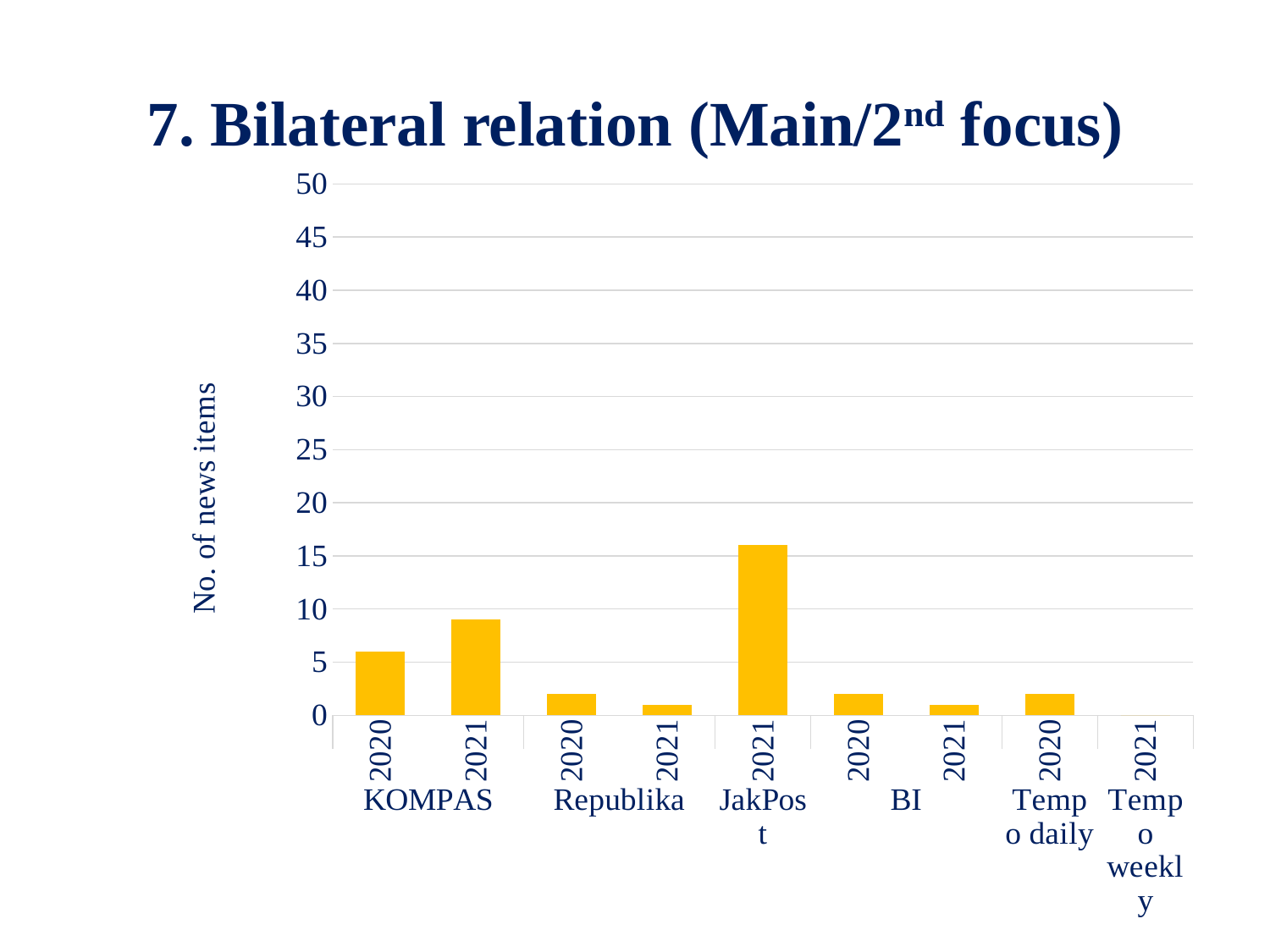
Is the value for Republika 2020 greater or less than 5? less What is the title of the chart on the slide? 7. Bilateral relation (Main/2nd focus) Which bar is the lowest in the chart? Tempo weekly 2021 Which bar is the highest in the chart? JakPost 2021 Which is larger, the value for KOMPAS 2020 or KOMPAS 2021? KOMPAS 2021 Is the value for JakPost 2021 greater or less than 10? greater Which is larger, the value for Republika 2020 or Republika 2021? Republika 2020 What kind of chart is shown on the slide? bar chart What is the label of the vertical axis? No. of news items How many bars (year-outlet categories) are shown along the x axis? 9 Is the value for KOMPAS 2021 greater or less than 10? less For KOMPAS, does the number of news items rise or fall from 2020 to 2021? rise